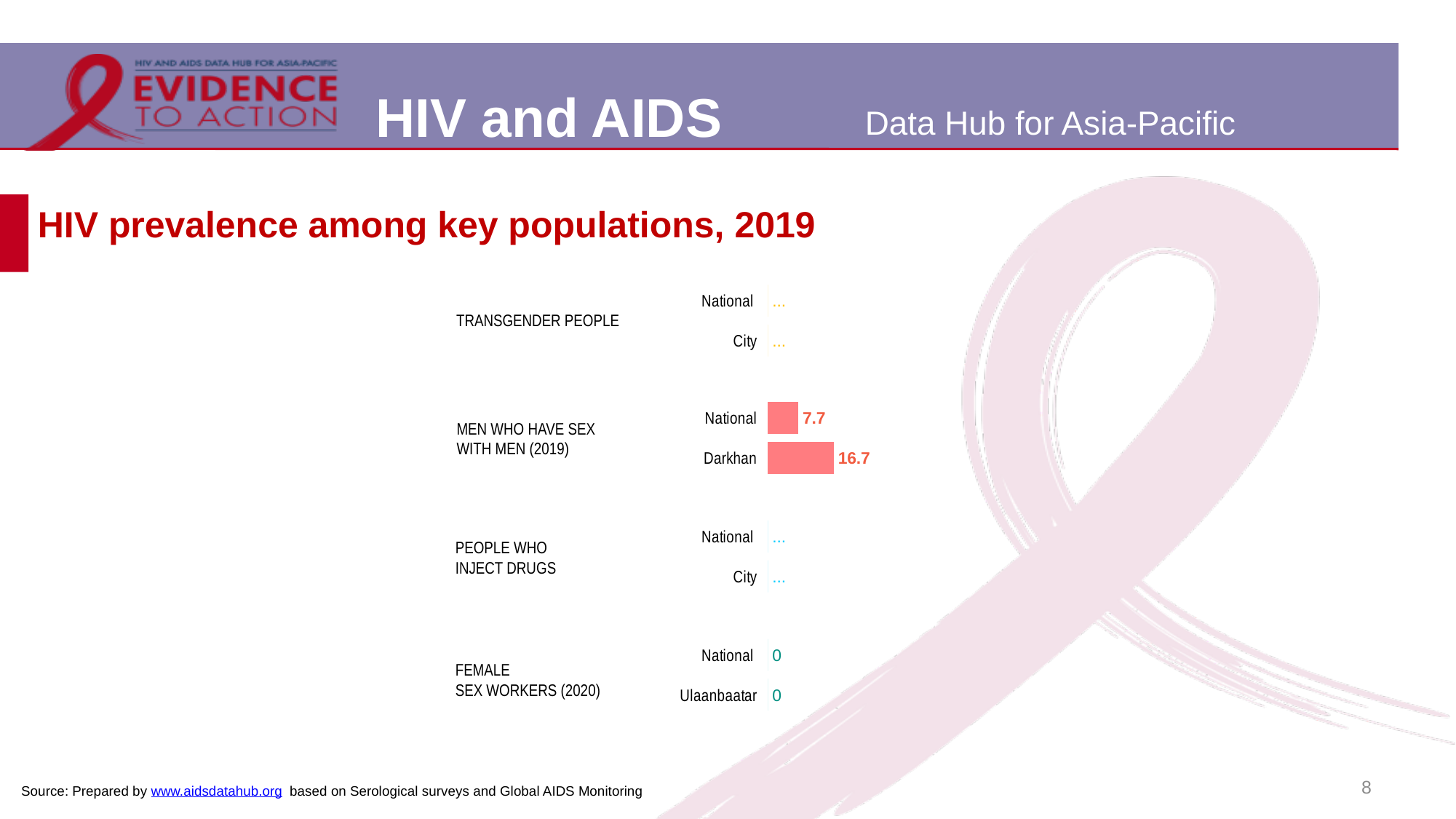
What is the HIV prevalence among men who have sex with men at the national level? 7.7 How many key population groups are listed on the chart? 4 What is the HIV prevalence among female sex workers at the national level? 0 For which key population is the city-level value reported for Darkhan? Men who have sex with men What kind of chart is shown on the slide? Bar chart What is the HIV prevalence among female sex workers in Ulaanbaatar? 0 What is the HIV prevalence among men who have sex with men in Darkhan? 16.7 What is the difference between the Darkhan and national HIV prevalence values for men who have sex with men? 9 What is the title of the chart? HIV prevalence among key populations, 2019 Which city is shown for female sex workers? Ulaanbaatar Which key population and location has the highest HIV prevalence shown on the chart? Men who have sex with men, Darkhan Which is larger for men who have sex with men: the national value or the Darkhan value? Darkhan